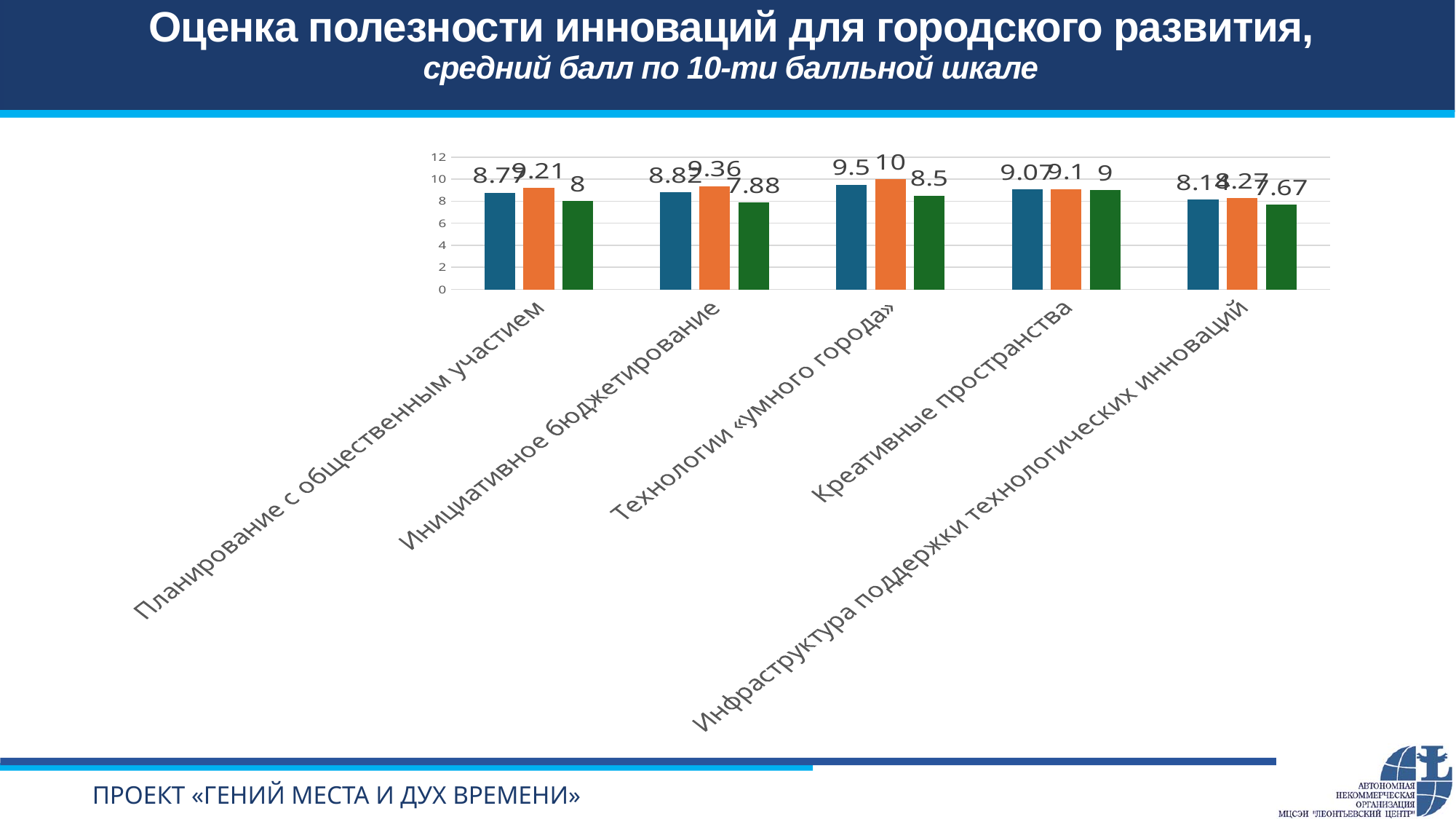
Which category has the lowest green bar? Инфраструктура поддержки технологических инноваций What is the difference between the orange and green bars for «Технологии «умного города»»? 1.5 Which category has the highest value on the chart? Технологии «умного города» What is the value of the green bar for «Инфраструктура поддержки технологических инноваций»? 7.67 What is the value of the green bar for «Инициативное бюджетирование»? 7.88 Which is larger: the green bar for «Планирование с общественным участием» or the green bar for «Инициативное бюджетирование»? Планирование с общественным участием How many bars are shown for each category? 3 What is the value of the orange bar for «Инициативное бюджетирование»? 9.36 What is the value of the green bar for «Технологии «умного города»»? 8.5 What is the value of the orange bar for «Технологии «умного города»»? 10 How many categories are shown on the x axis? 5 What type of chart is shown on the slide? Bar chart